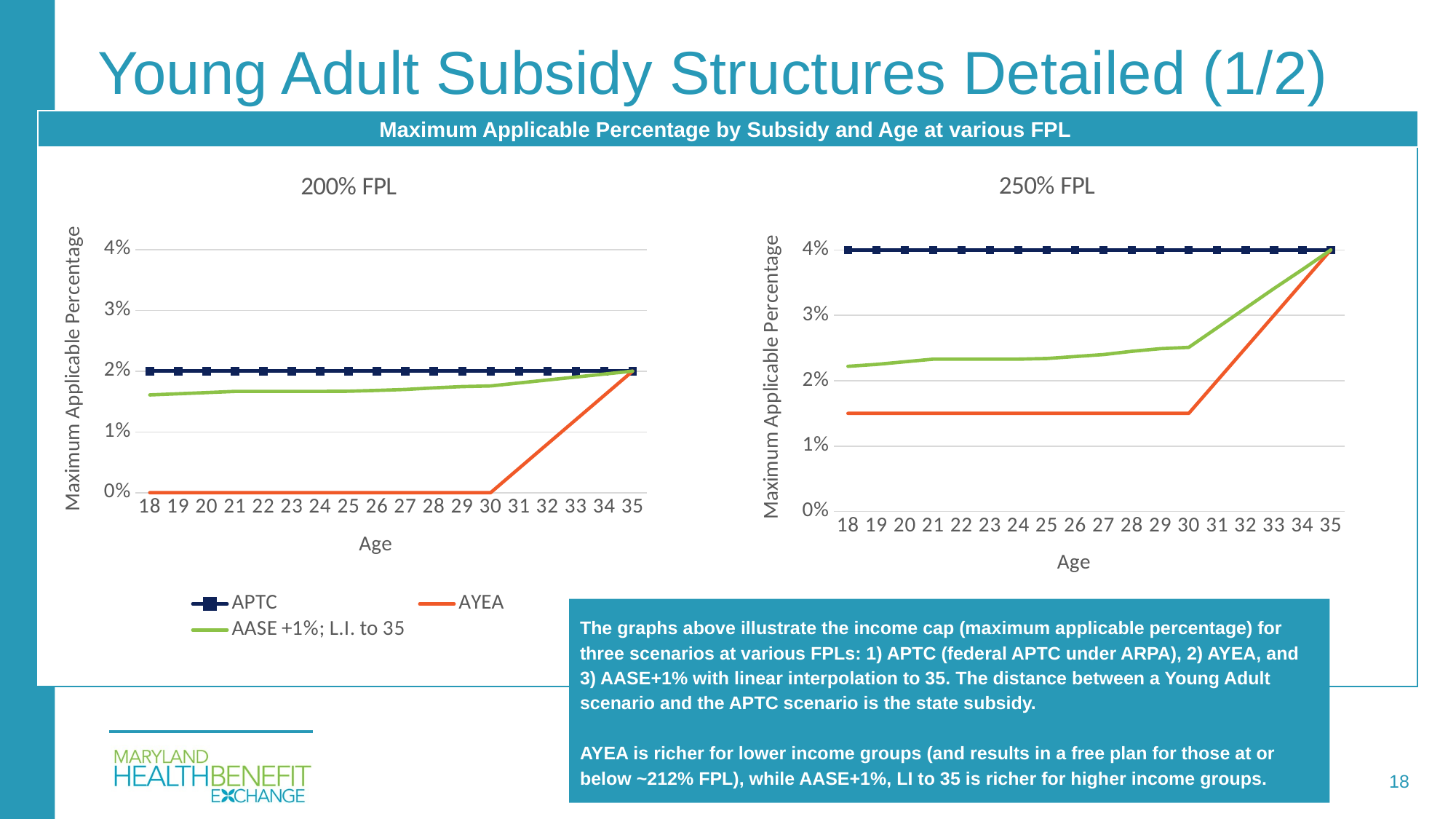
In the 200% FPL chart, what is the AYEA value at age 22? 0% How many series does the legend list? 3 In the 250% FPL chart, what is the APTC value at age 20? 4% In the 200% FPL chart, what is the APTC value at age 25? 2% What kind of chart is the 200% FPL chart? line chart In the 250% FPL chart, which series has the highest value at age 18? APTC In the 250% FPL chart, does the AYEA line rise or fall between age 30 and age 35? rise What is the title shown above the two charts? Maximum Applicable Percentage by Subsidy and Age at various FPL In the 200% FPL chart, at age 20, which is larger: APTC or AASE +1%; L.I. to 35? APTC In the 250% FPL chart, how many ages are shown on the x axis? 18 In the 250% FPL chart, is the AYEA value at age 25 greater or less than 2%? less In the 250% FPL chart, is the AASE +1%; L.I. to 35 value at age 20 greater or less than 2%? greater